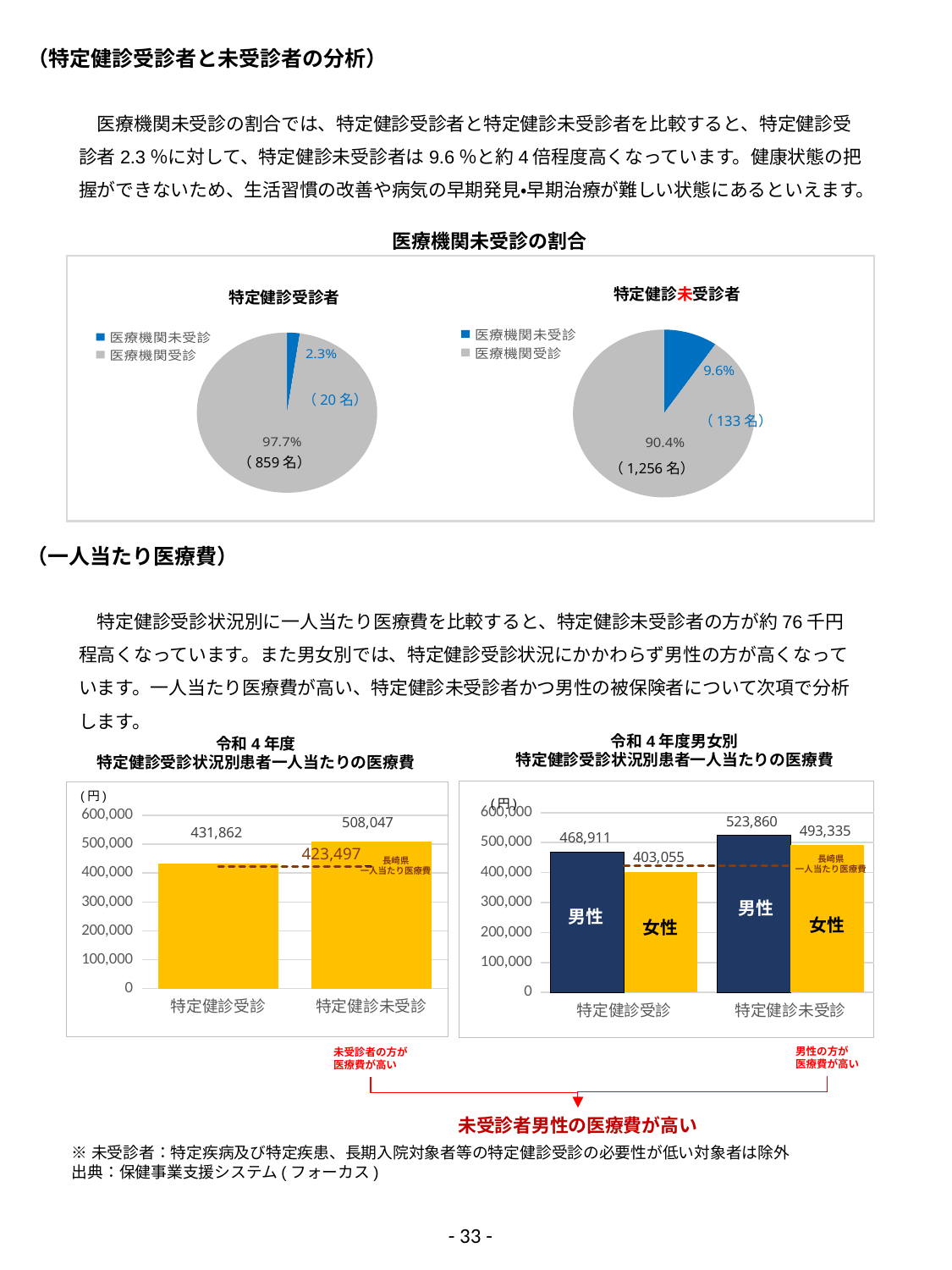
In the pie chart titled 特定健診受診者, what share is labelled for 医療機関未受診? 2.3% In the bar chart titled 令和4年度 特定健診受診状況別患者一人当たりの医療費, what is the difference between 特定健診未受診 and 特定健診受診? 76,185 In the bar chart titled 令和4年度 特定健診受診状況別患者一人当たりの医療費, what value is shown for the dashed 長崎県一人当たり医療費 line? 423,497 In the bar chart titled 令和4年度男女別 特定健診受診状況別患者一人当たりの医療費, which bar is the highest? 男性 under 特定健診未受診 (523,860) In the pie chart titled 特定健診受診者, how many people (名) are in the 医療機関受診 slice? 859名 In the pie chart titled 特定健診未受診者, what share is labelled for 医療機関受診? 90.4% In the pie chart titled 特定健診未受診者, what share is labelled for 医療機関未受診? 9.6% In the bar chart titled 令和4年度男女別 特定健診受診状況別患者一人当たりの医療費, what is the value for 女性 under 特定健診受診? 403,055 In the bar chart titled 令和4年度男女別 特定健診受診状況別患者一人当たりの医療費, what is the difference between 男性 and 女性 under 特定健診未受診? 30,525 In the bar chart titled 令和4年度 特定健診受診状況別患者一人当たりの医療費, what is the value for 特定健診未受診? 508,047 In the pie chart titled 特定健診未受診者, how many people (名) are in the 医療機関未受診 slice? 133名 How many entries does the legend of the pie chart titled 特定健診受診者 list? 2